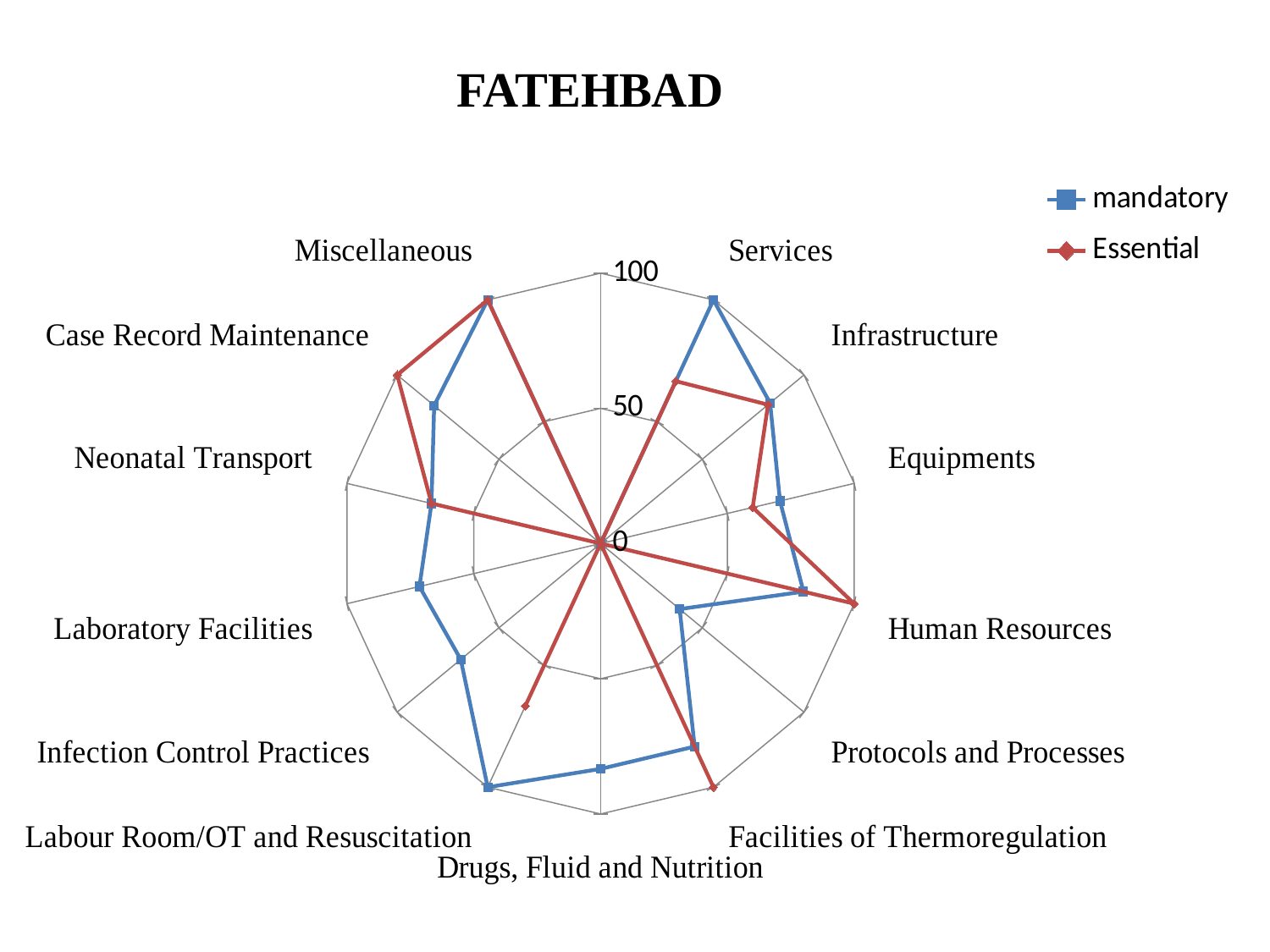
What colour is used for the Essential series? red For Human Resources, which series has the larger value, mandatory or Essential? Essential What kind of chart is shown on the slide? radar chart Is the mandatory value for Protocols and Processes greater or less than 50? less How many categories (axes) does the radar chart have? 14 How many series does the legend list? 2 Is the mandatory value for Drugs, Fluid and Nutrition greater or less than 50? greater For Services, which series has the larger value, mandatory or Essential? mandatory Is the Essential value for Labour Room/OT and Resuscitation greater or less than 50? greater What is the title of the chart? FATEHBAD For Case Record Maintenance, which series has the larger value, mandatory or Essential? Essential